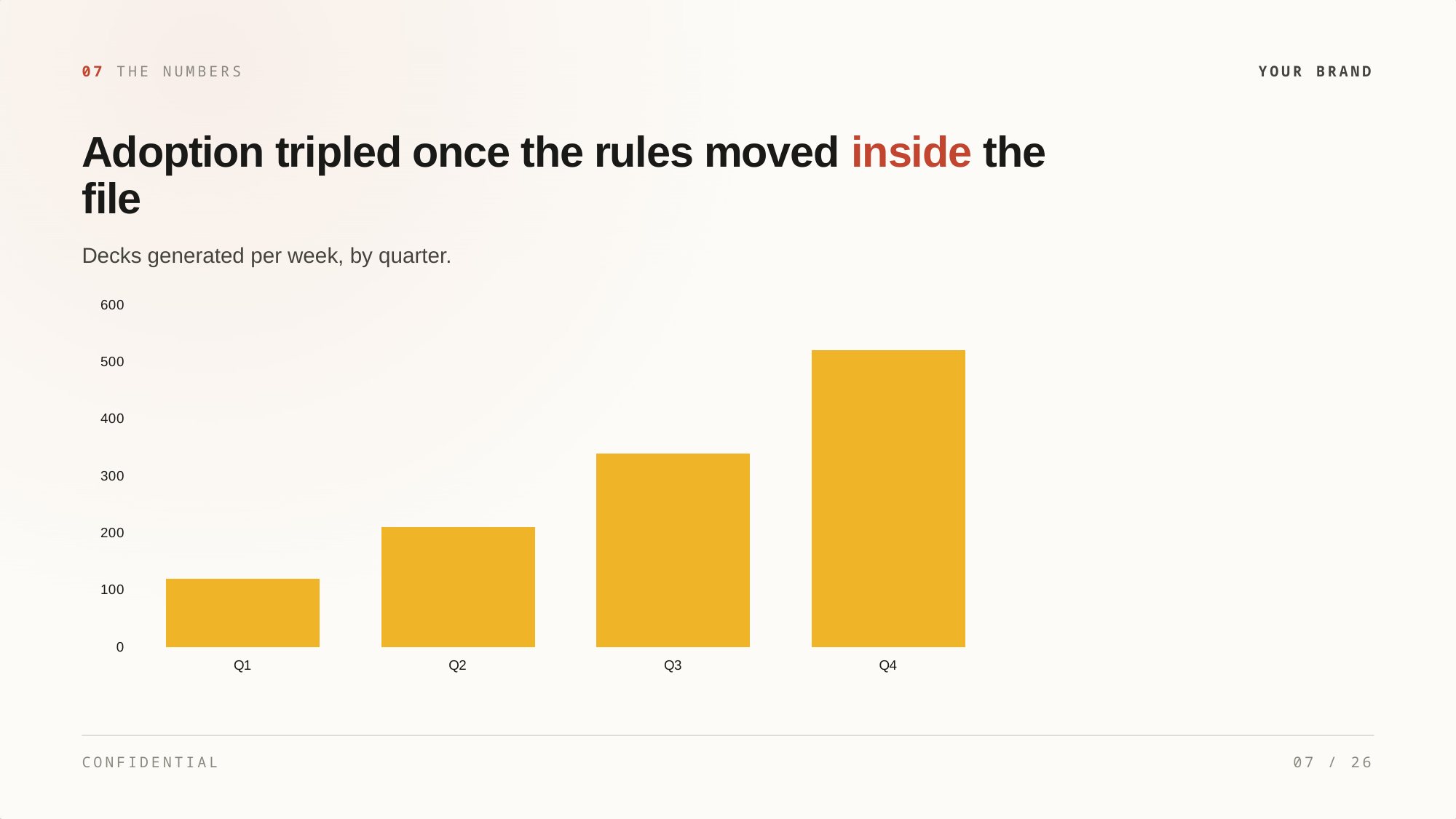
Which quarter has the lowest number of decks generated per week? Q1 How many quarters are plotted on the chart? 4 What is the highest value shown on the vertical axis? 600 Which is larger, the value for Q2 or the value for Q3? Q3 Which quarter has the highest number of decks generated per week? Q4 Is the value for Q4 greater or less than 400? greater Is the value for Q2 greater or less than 300? less What does the chart measure, according to the subtitle above it? Decks generated per week, by quarter. Is the value for Q3 greater or less than 300? greater Do the values rise or fall from Q1 to Q4? rise What kind of chart is shown on the slide? bar chart